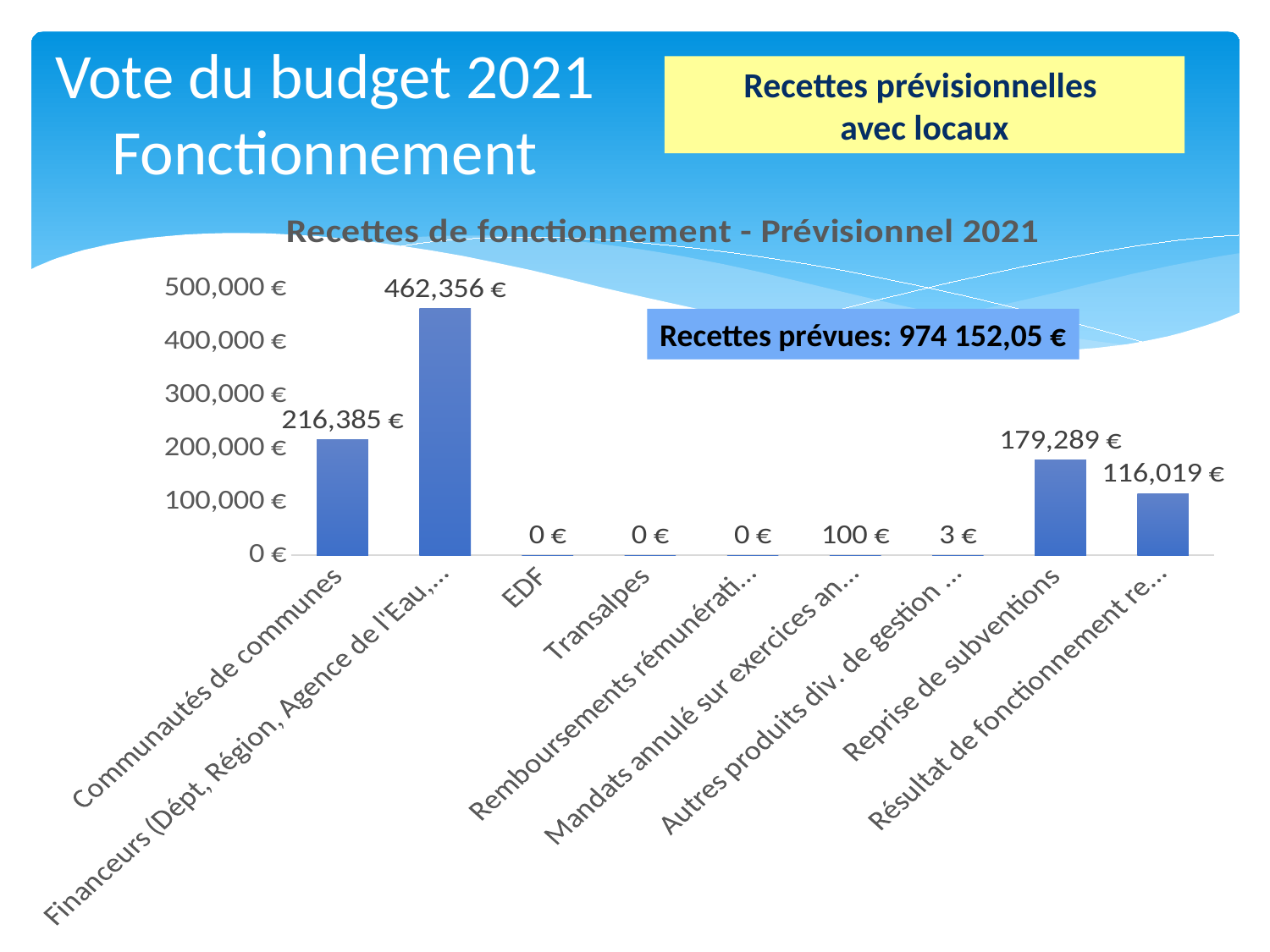
What is the difference between the values for Financeurs (Dépt, Région, Agence de l'Eau,...) and Communautés de communes? 245,971 € What is the difference between the values for Communautés de communes and Reprise de subventions? 37,096 € What is the value for EDF? 0 € How many categories are shown on the x axis? 9 What is the value for Communautés de communes? 216,385 € What kind of chart is this? Bar chart What is the value of the rightmost bar (Résultat de fonctionnement re...)? 116,019 € What is the title of the chart? Recettes de fonctionnement - Prévisionnel 2021 What is the value for Reprise de subventions? 179,289 € Which category has the highest value? Financeurs (Dépt, Région, Agence de l'Eau,...) Which is larger, the value for Communautés de communes or the value for Reprise de subventions? Communautés de communes What is the value for Transalpes? 0 €